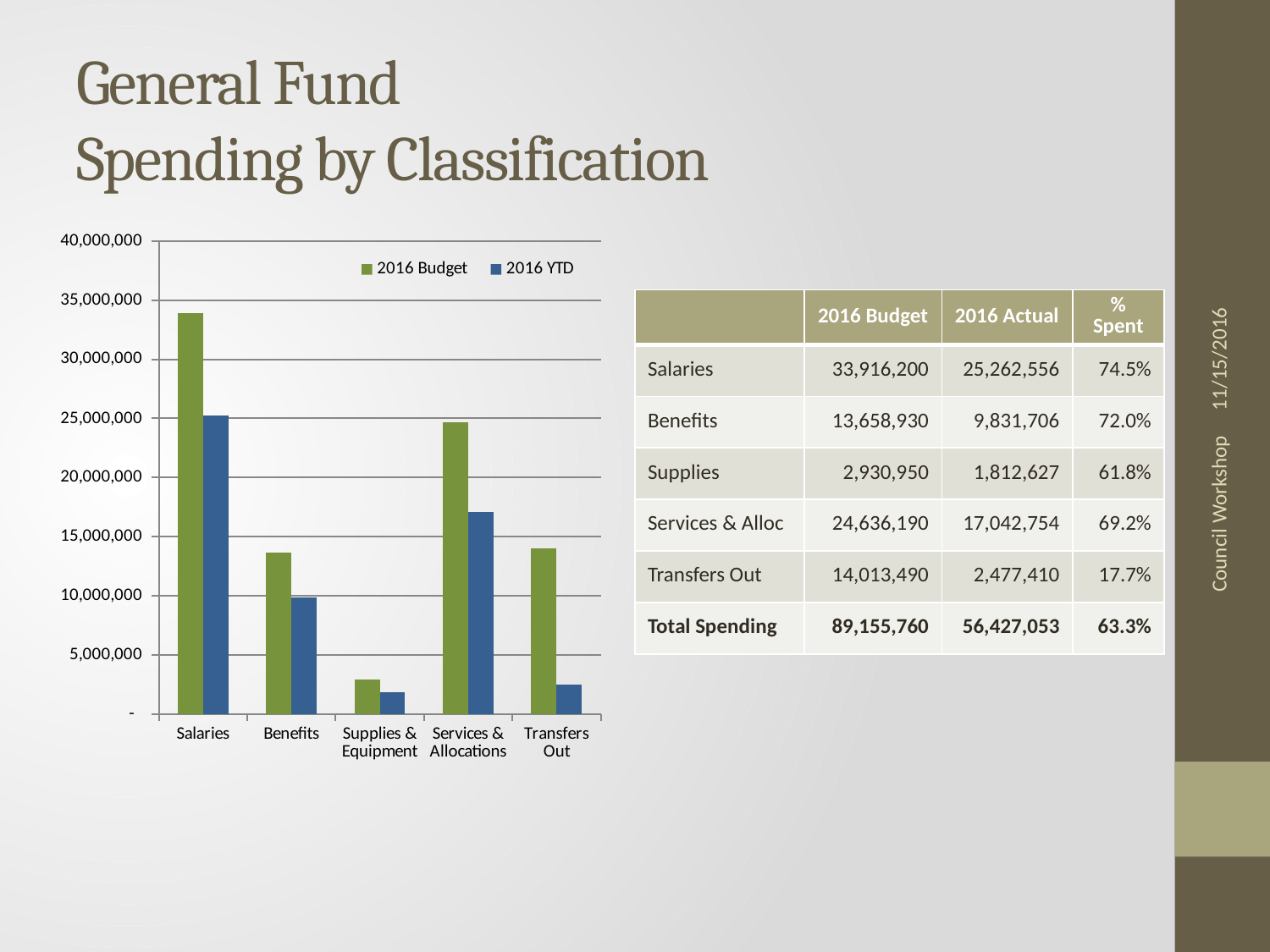
What are the two series named in the chart's legend? 2016 Budget and 2016 YTD Is the 2016 YTD value for Transfers Out greater or less than 5,000,000? less Which category has the lowest 2016 Budget bar? Supplies & Equipment What kind of chart is shown on the slide? Bar chart Which category has the highest 2016 Budget bar? Salaries How many spending categories are shown on the chart's x axis? 5 Is the 2016 Budget value for Salaries greater or less than 30,000,000? greater Which is larger: the 2016 YTD value for Services & Allocations or the 2016 YTD value for Benefits? Services & Allocations Is the 2016 Budget value for Benefits greater or less than 10,000,000? greater How many series does the chart's legend list? 2 According to the table on the slide, what is the 2016 Budget for Salaries? 33,916,200